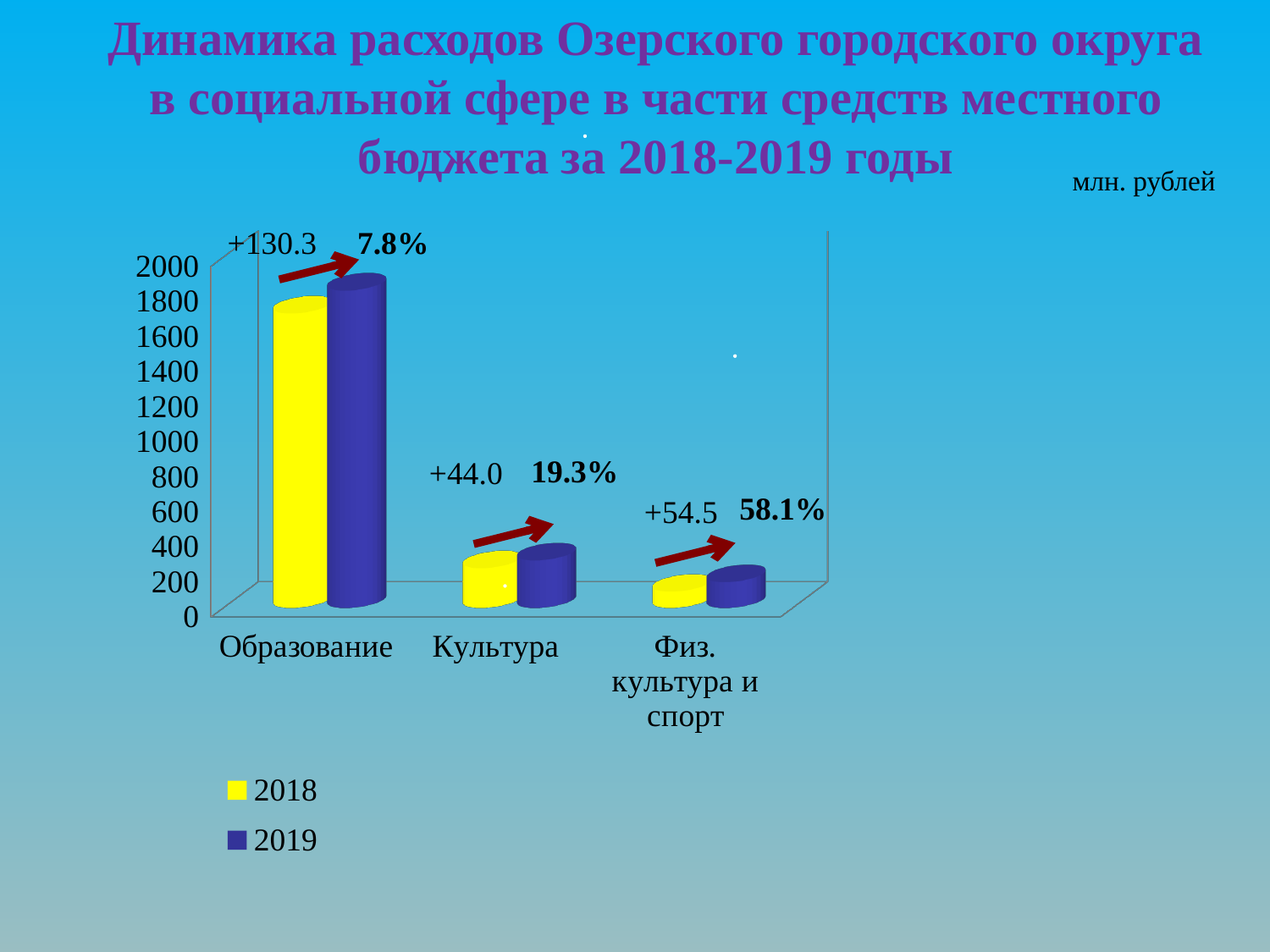
Is the 2018 value for Физ. культура и спорт greater or less than 200? less Is the 2019 value for Культура greater or less than 400? less What increase in million rubles is annotated above the Культура bars? +44.0 For Культура, which year has the larger value, 2018 or 2019? 2019 Which category has the highest expenditure in 2019? Образование Which colour represents the 2018 series in the legend? yellow What percentage growth is annotated for Физ. культура и спорт? 58.1% How many categories are shown on the x axis of the chart? 3 Is the 2018 value for Образование greater or less than 1600? greater What kind of chart is shown on the slide? bar chart Which category has the lowest expenditure in 2018? Физ. культура и спорт How many series does the chart legend list? 2